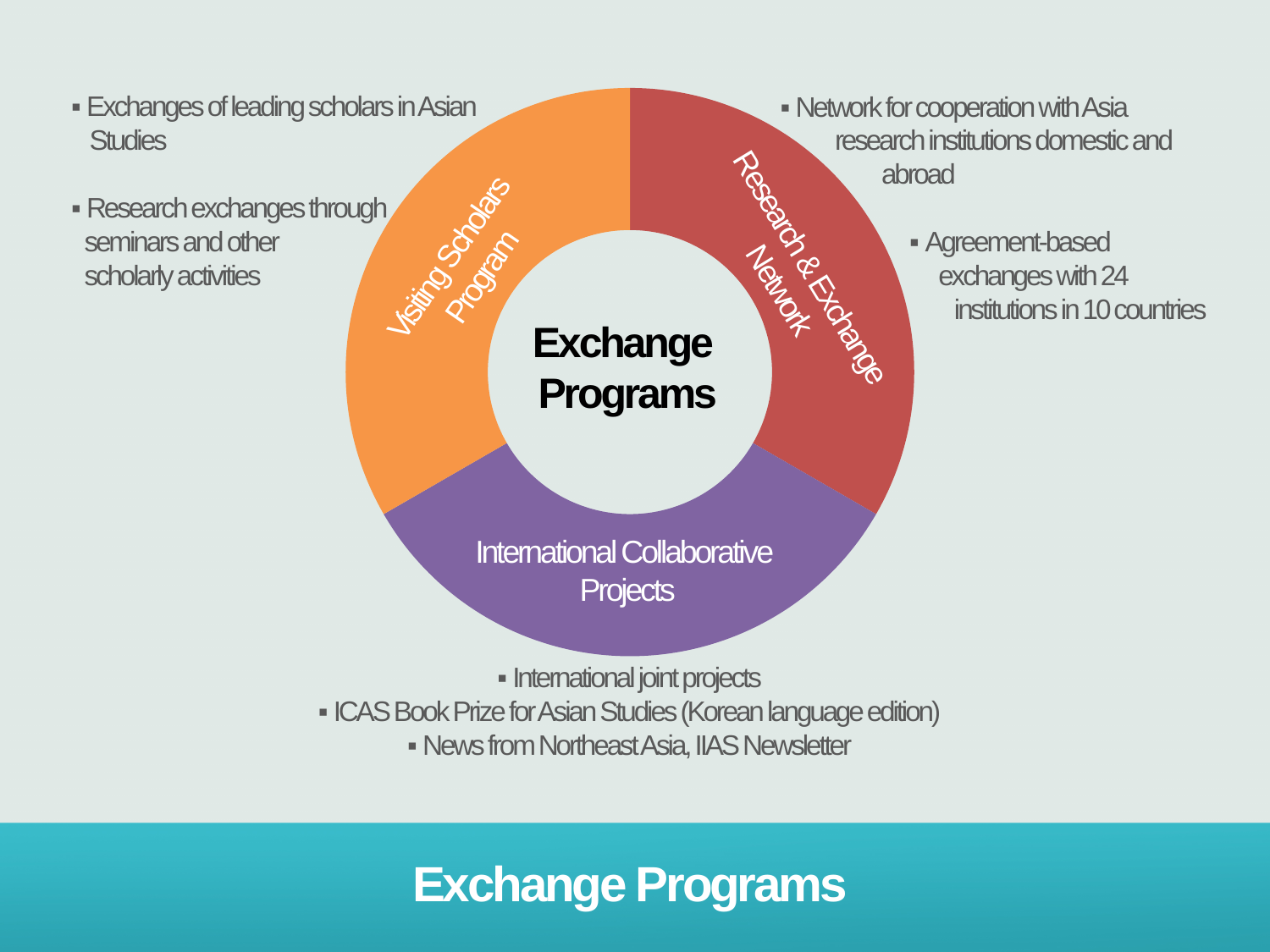
Which segment of the doughnut chart is coloured orange? Visiting Scholars Program Which segment of the doughnut chart is at the bottom? International Collaborative Projects What text appears in the centre of the doughnut chart? Exchange Programs What kind of chart is shown on the slide? Doughnut chart How many segments does the doughnut chart have? 3 Which segment of the doughnut chart is coloured red? Research & Exchange Network Which segment of the doughnut chart is coloured purple? International Collaborative Projects